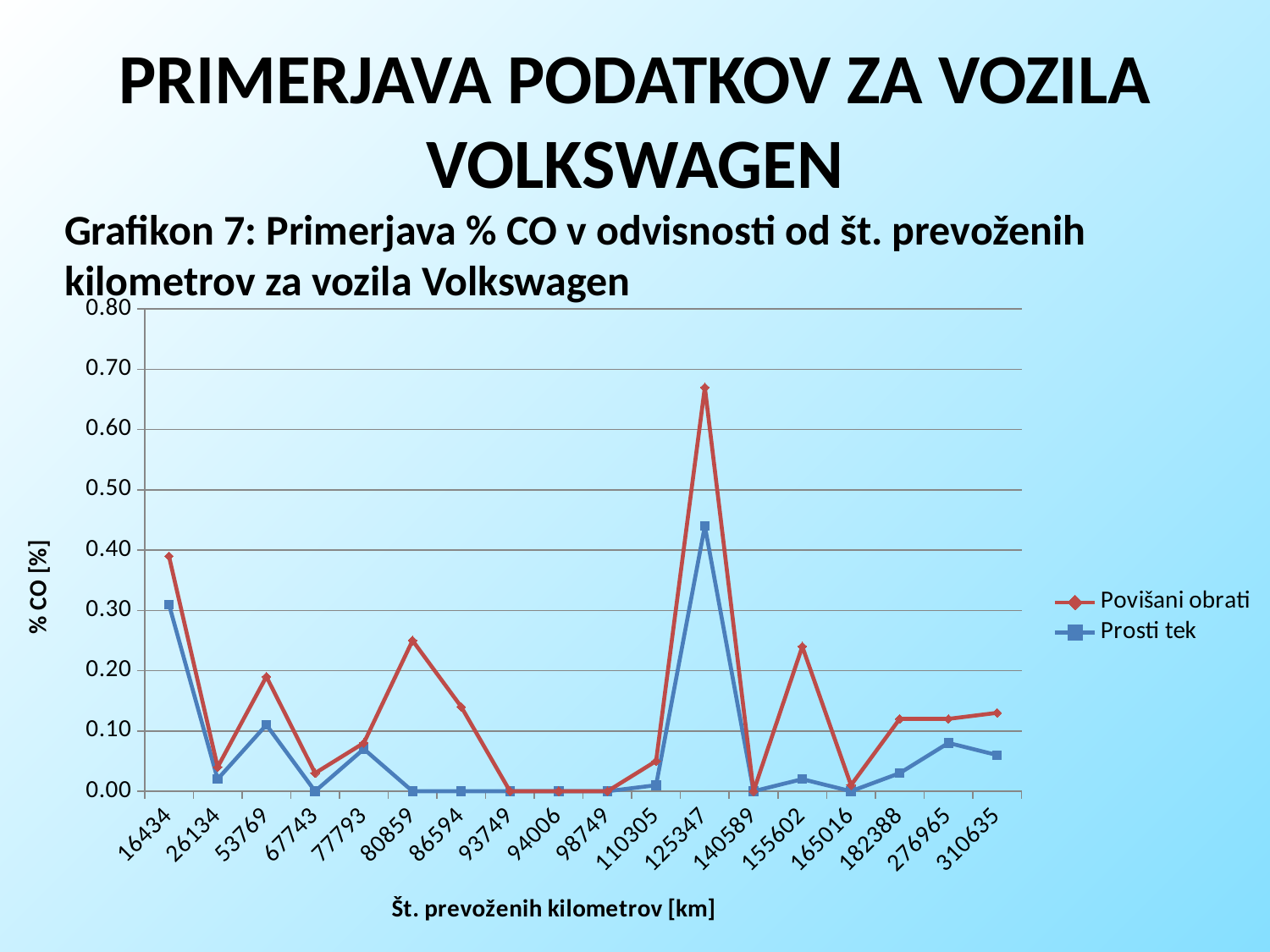
What kind of chart is shown on the slide? line chart At which kilometre value does the Prosti tek series reach its highest % CO? 125347 What is the label of the y axis? % CO [%] How many kilometre categories are shown on the x axis? 18 At 16434 km, which series has the higher % CO, Povišani obrati or Prosti tek? Povišani obrati At which kilometre value does the Povišani obrati series reach its highest % CO? 125347 What is the Prosti tek value at 86594 km? 0.00 Is the Povišani obrati value at 80859 km greater or less than 0.20? greater What is the Povišani obrati value at 94006 km? 0.00 Is the Povišani obrati value at 125347 km greater or less than 0.60? greater Is the Povišani obrati value at 16434 km greater or less than 0.30? greater How many series does the legend list? 2